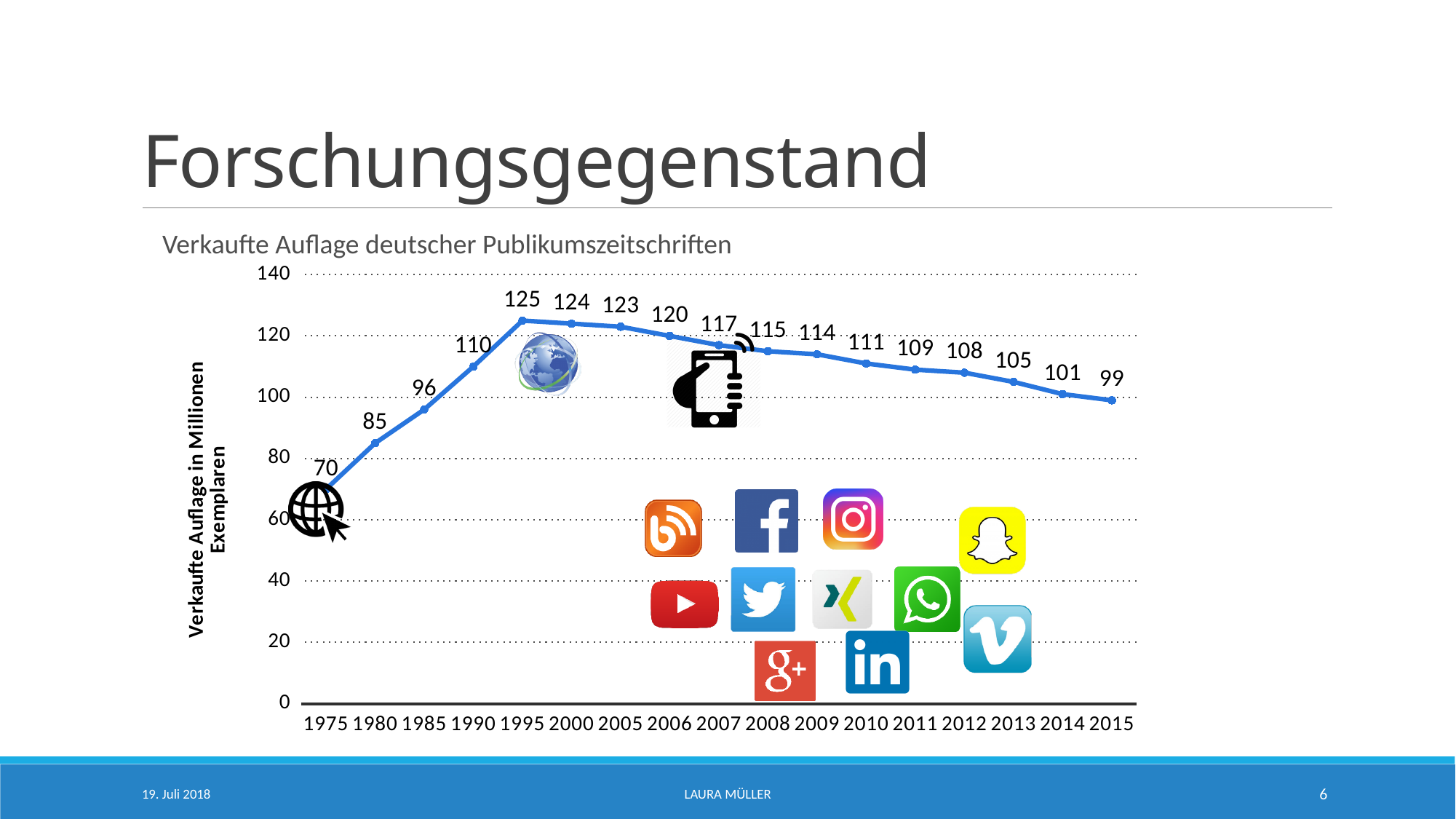
What is the value for 1995? 125 What is the value for 2015? 99 What is the value for 1975? 70 What is the value for 2008? 115 What is the difference between the values for 1995 and 2015? 26 Which is larger, the value for 1990 or the value for 2010? 2010 Which year has the highest value? 1995 What kind of chart is shown? line chart How many years are plotted on the x axis? 17 Which year has the lowest value? 1975 What is the title of the chart? Verkaufte Auflage deutscher Publikumszeitschriften Do the values rise or fall from 2000 to 2015? fall